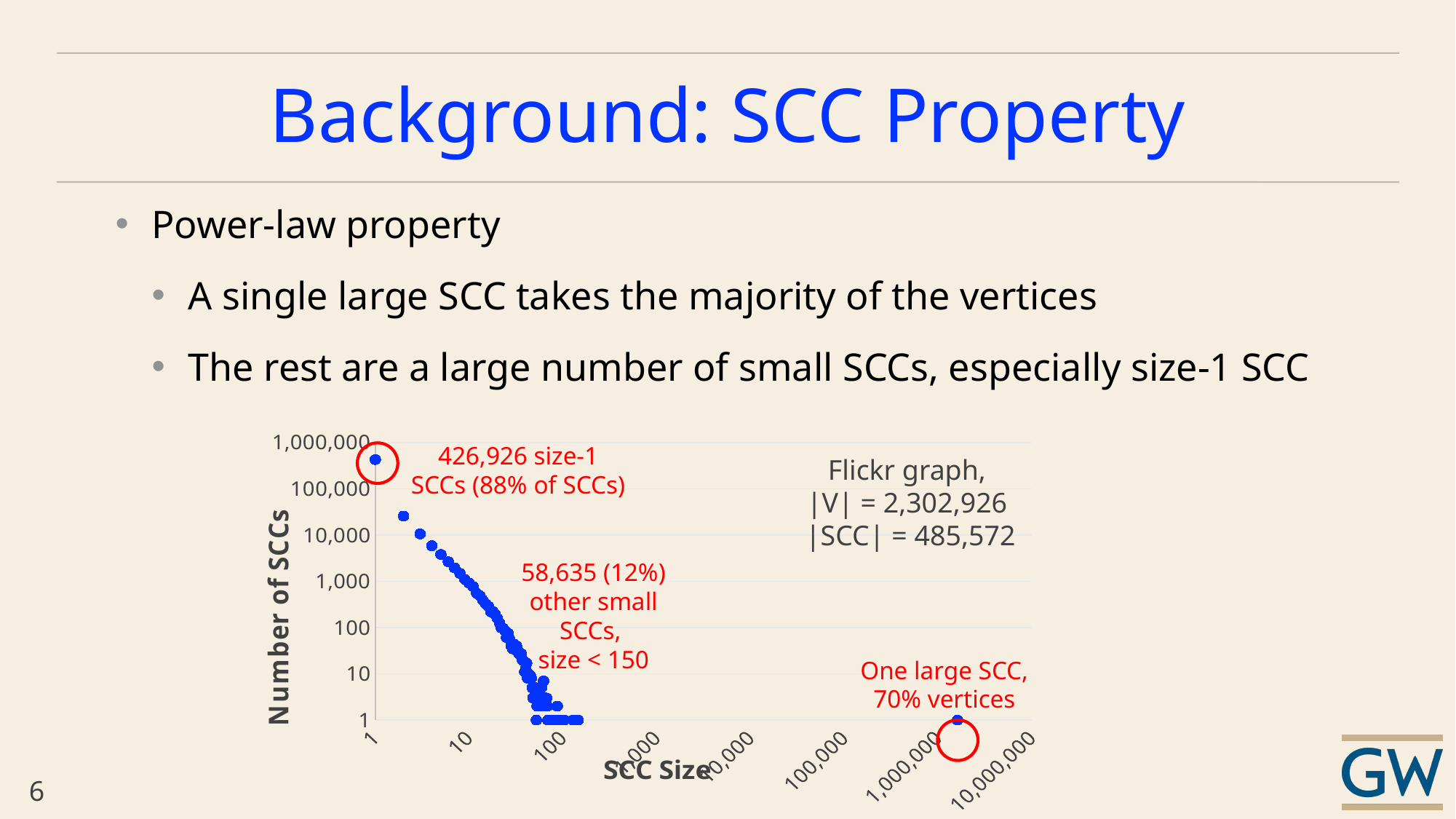
According to the chart annotation, how many size-1 SCCs are there? 426,926 How many other small SCCs (size < 150) does the chart annotation report? 58,635 What kind of chart is shown on the slide? scatter plot What is the label of the y axis of the chart? Number of SCCs Which graph dataset does the chart describe? Flickr graph Is the number of size-1 SCCs greater or less than 100,000? greater Does the number of SCCs rise or fall as SCC size increases along the x axis? fall What percentage of SCCs are size-1 SCCs, according to the chart annotation? 88% What is |V| for the Flickr graph shown on the chart? 2,302,926 What is |SCC| for the Flickr graph shown on the chart? 485,572 Which SCC size has the highest number of SCCs? 1 What share of the vertices does the one large SCC contain, according to the chart? 70%